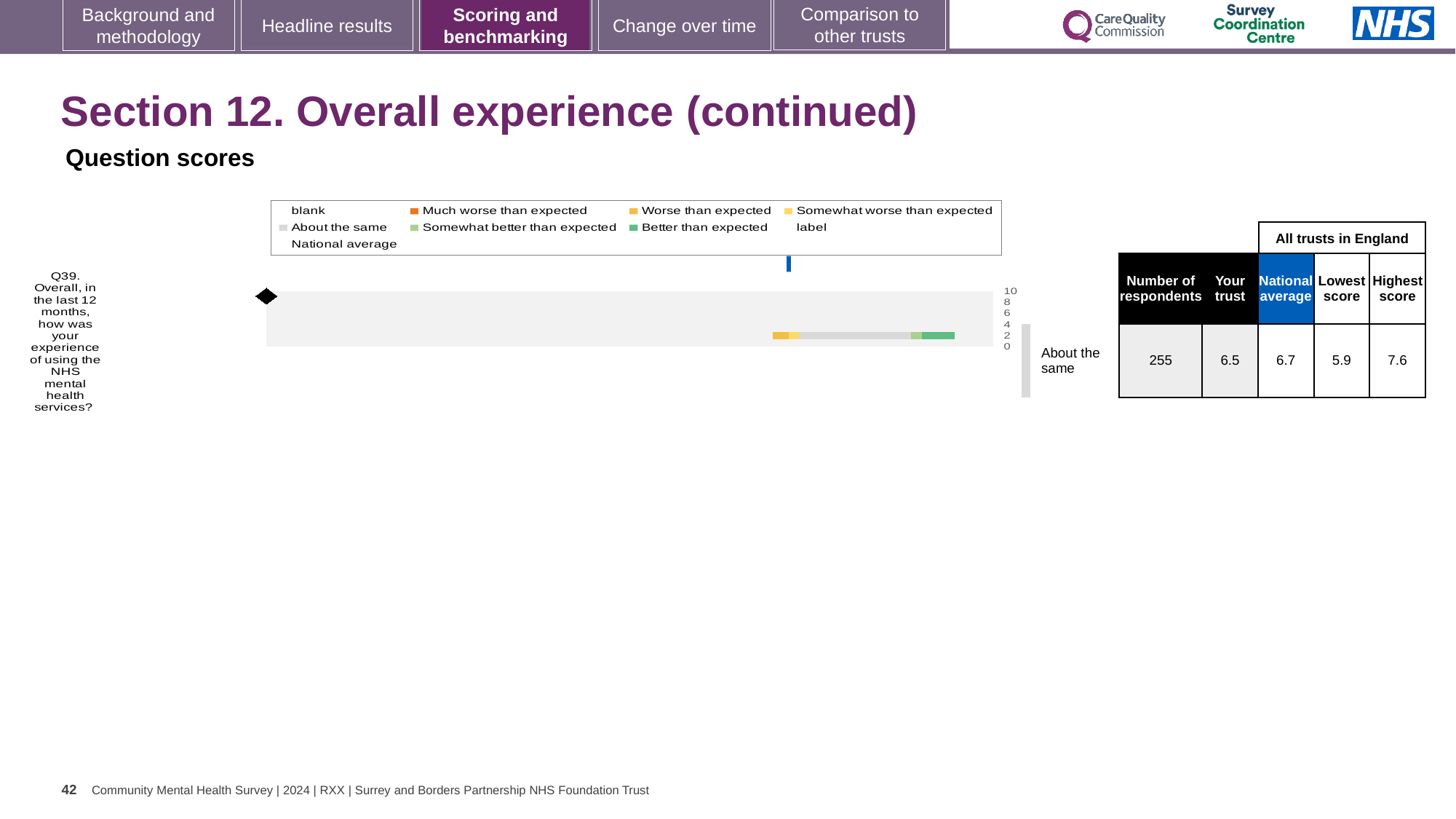
What benchmark category label is shown beside the Q39 bar? About the same How many questions are plotted in the chart on this slide? 1 What is the lowest score among all trusts in England for Q39? 5.9 Which is larger for Q39: the 'Your trust' score or the national average? National average What is the difference between the highest score and the lowest score for Q39? 1.7 What is the national average score for Q39 shown in the table? 6.7 What is the 'Your trust' score for Q39 in the table next to the chart? 6.5 What is the highest score among all trusts in England for Q39? 7.6 By how much does the national average exceed the 'Your trust' score for Q39? 0.2 What colour does the legend use for 'Better than expected'? Green How many respondents answered Q39 according to the table? 255 What kind of chart is shown on the slide for Q39? bar chart